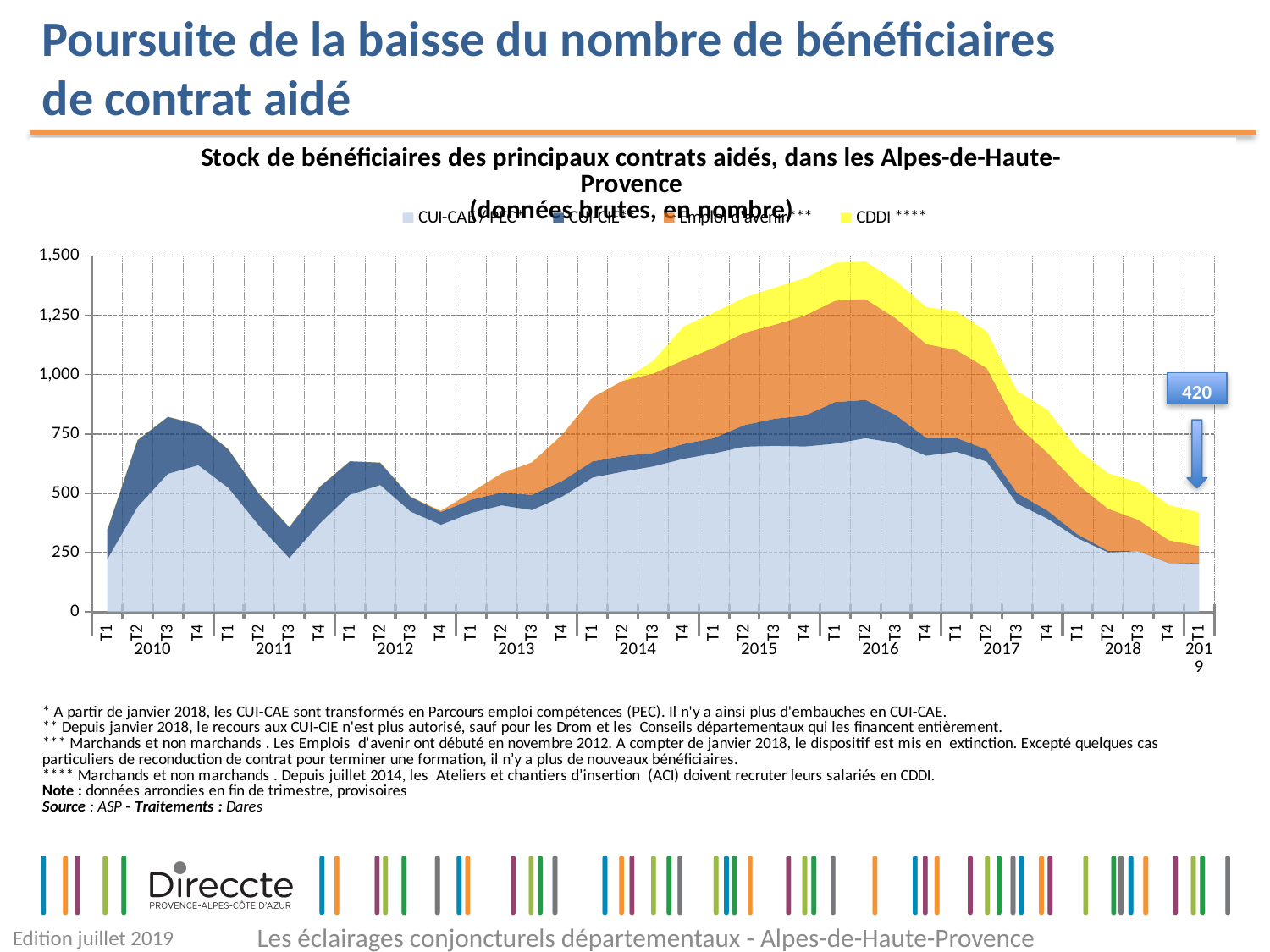
Which series is shown in yellow? CDDI **** How many series does the legend list? 4 Is the total value at T3 2011 greater or less than 500? less Does the total stock of beneficiaries rise or fall between 2012 and 2016? rise What is the total stock of beneficiaries shown by the data label at T1 2019? 420 What kind of chart is shown on the slide? area chart Does the total stock of beneficiaries rise or fall between 2016 and 2019? fall How many years are labelled on the x axis? 10 Is the total value at T1 2014 greater or less than 750? greater Is the total value at T2 2016 greater or less than 1,250? greater In which year does the total stock of beneficiaries reach its highest level? 2016